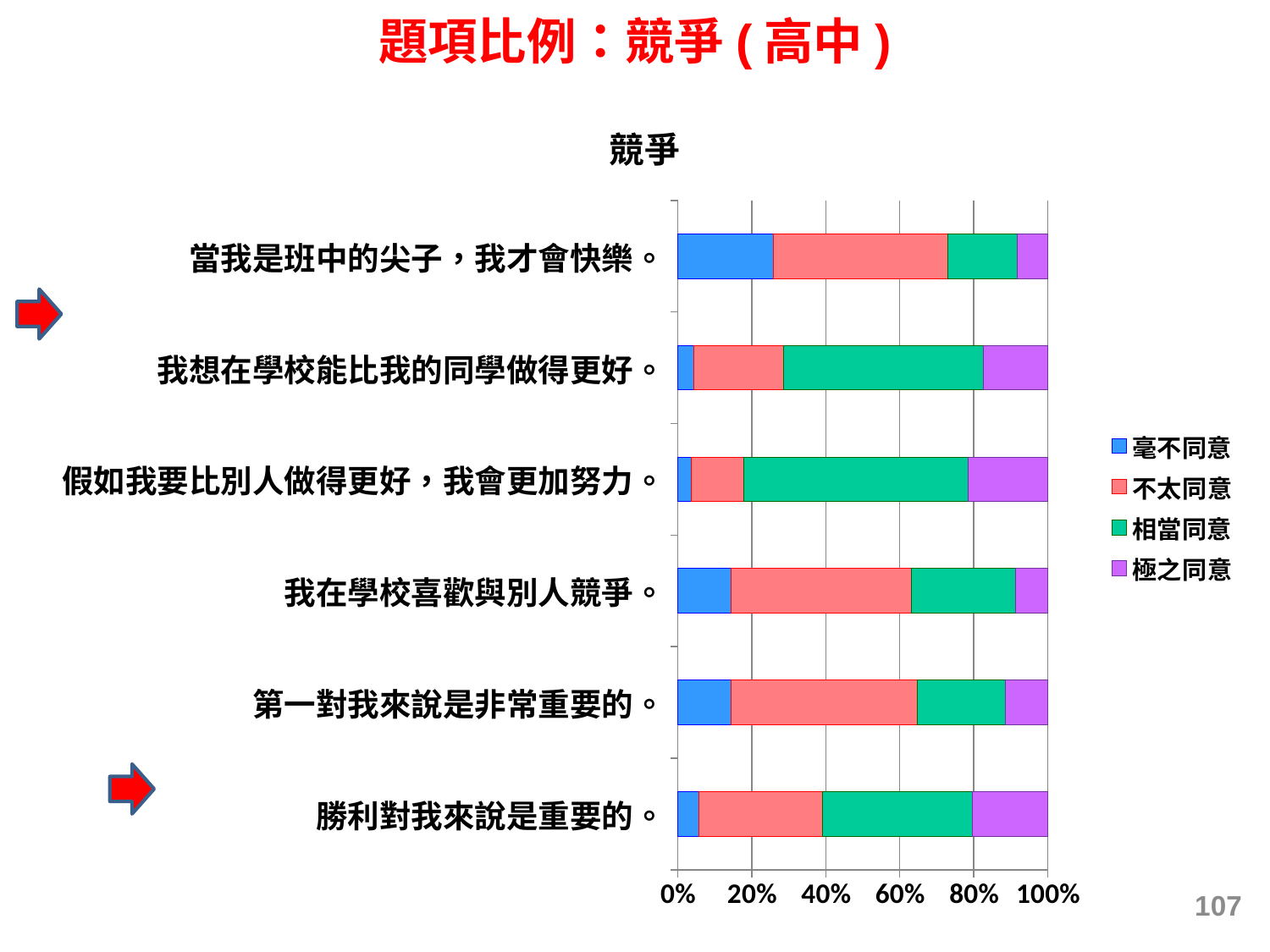
Is the 毫不同意 value for 「我想在學校能比我的同學做得更好。」 greater or less than 20%? less How many statements (categories) are plotted in the chart? 6 Which statement has the larger 極之同意 share: 「勝利對我來說是重要的。」 or 「當我是班中的尖子，我才會快樂。」? 勝利對我來說是重要的。 Which statement has the largest 相當同意 share? 假如我要比別人做得更好，我會更加努力。 Which statement has the larger 不太同意 share: 「當我是班中的尖子，我才會快樂。」 or 「勝利對我來說是重要的。」? 當我是班中的尖子，我才會快樂。 Is the 毫不同意 value for 「當我是班中的尖子，我才會快樂。」 greater or less than 20%? greater Which statement has the largest 毫不同意 share? 當我是班中的尖子，我才會快樂。 Is the 相當同意 value for 「假如我要比別人做得更好，我會更加努力。」 greater or less than 40%? greater Which legend entry is shown in green? 相當同意 How many series does the legend list? 4 What is the title of the chart? 競爭 What kind of chart is shown on the slide? Stacked bar chart